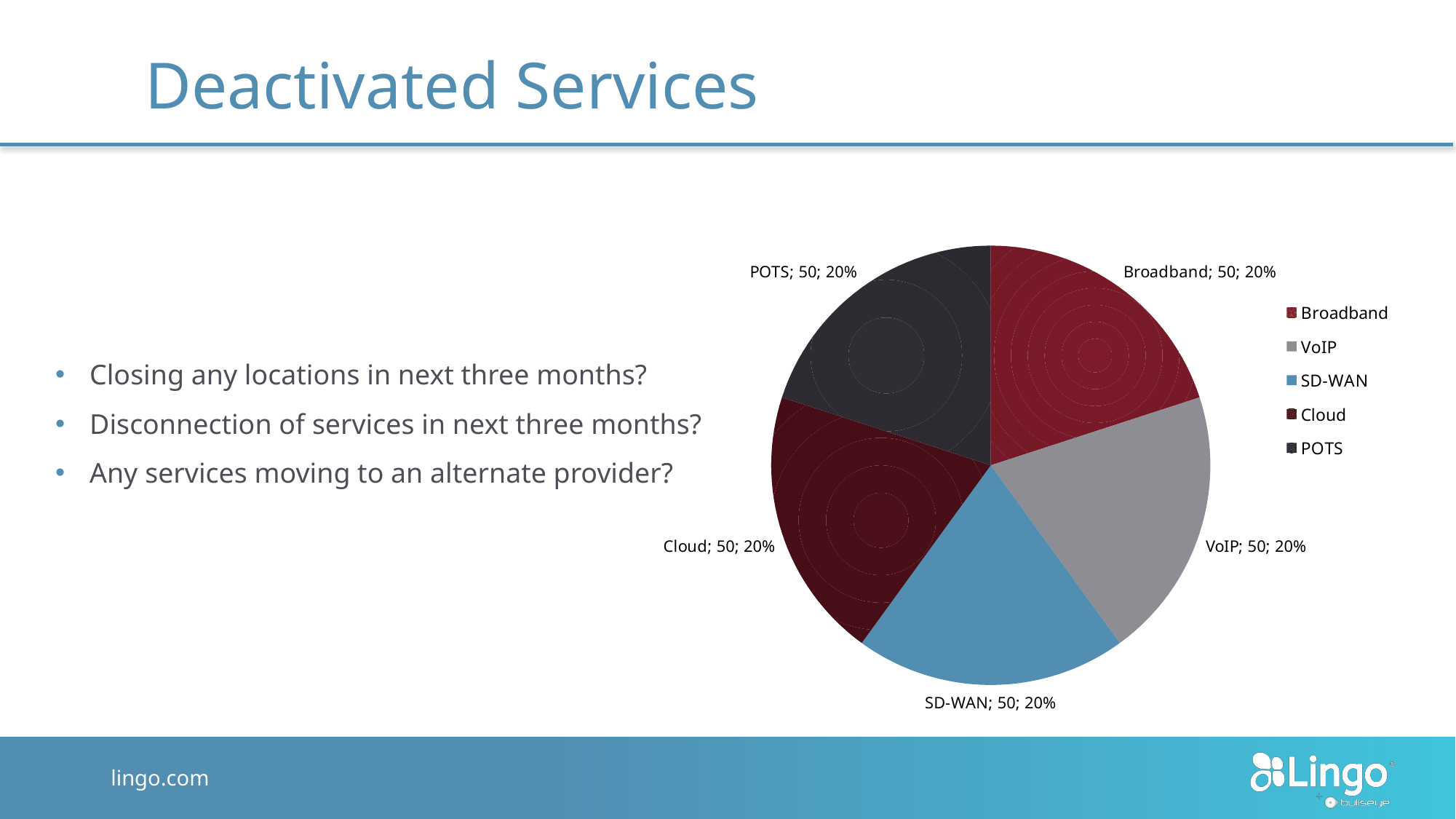
What share of the pie does POTS represent? 20% What is the total of all slice values in the pie chart? 250 What share of the pie does VoIP represent? 20% How many slices does the pie chart have? 5 What is the difference between the values for Cloud and VoIP? 0 What is the value for Broadband? 50 What kind of chart is shown on the slide? pie chart Which legend entry is shown in blue? SD-WAN What is the value for SD-WAN? 50 Which legend entry is listed first? Broadband How many entries does the legend list? 5